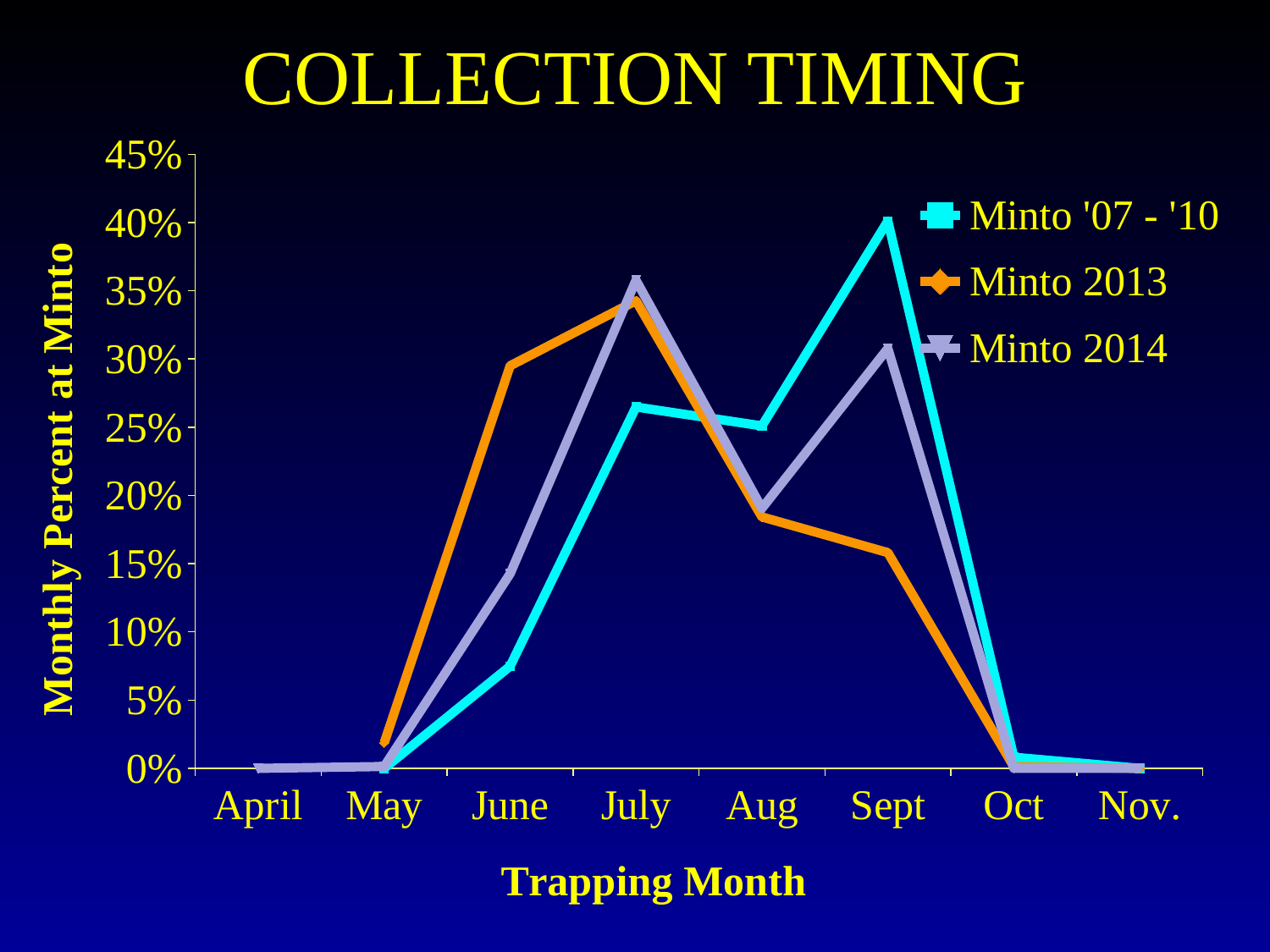
What is the title of the x axis? Trapping Month Is the value for Minto '07 - '10 in June greater or less than 10%? less What kind of chart is shown on the slide? Line chart Is the value for Minto '07 - '10 in Sept greater or less than 35%? greater In which month does the Minto 2013 series reach its highest value? July Is the value for Minto 2013 in June greater or less than 25%? greater In Sept, which series has the higher value, Minto '07 - '10 or Minto 2013? Minto '07 - '10 How many series does the legend list? 3 In June, which series has the higher value, Minto 2013 or Minto 2014? Minto 2013 In which month does the Minto 2014 series reach its highest value? July How many trapping months are shown on the x axis? 8 In which month does the Minto '07 - '10 series reach its highest value? Sept